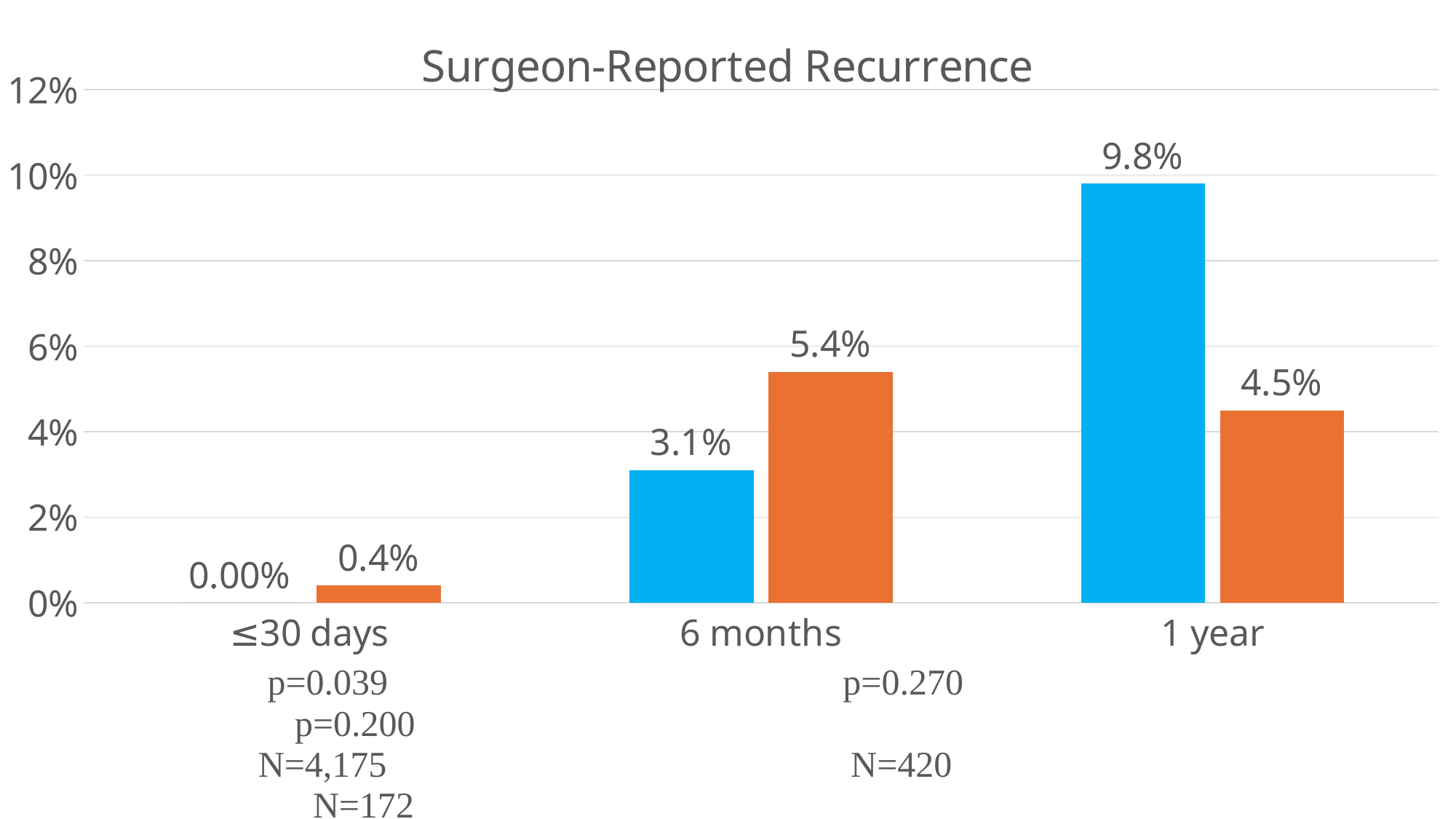
What is the difference between the blue and orange bars for 1 year? 5.3% For 6 months, which bar is larger, blue or orange? orange What is the title of the chart? Surgeon-Reported Recurrence What is the value of the orange bar for 6 months? 5.4% How many categories are shown on the x axis? 3 What is the value of the orange bar for ≤30 days? 0.4% Which category has the lowest orange bar? ≤30 days What kind of chart is shown on the slide? bar chart Which category has the highest blue bar? 1 year Do the blue bar values rise or fall from ≤30 days to 1 year? rise What is the value of the blue bar for ≤30 days? 0.00% What is the value of the blue bar for 1 year? 9.8%